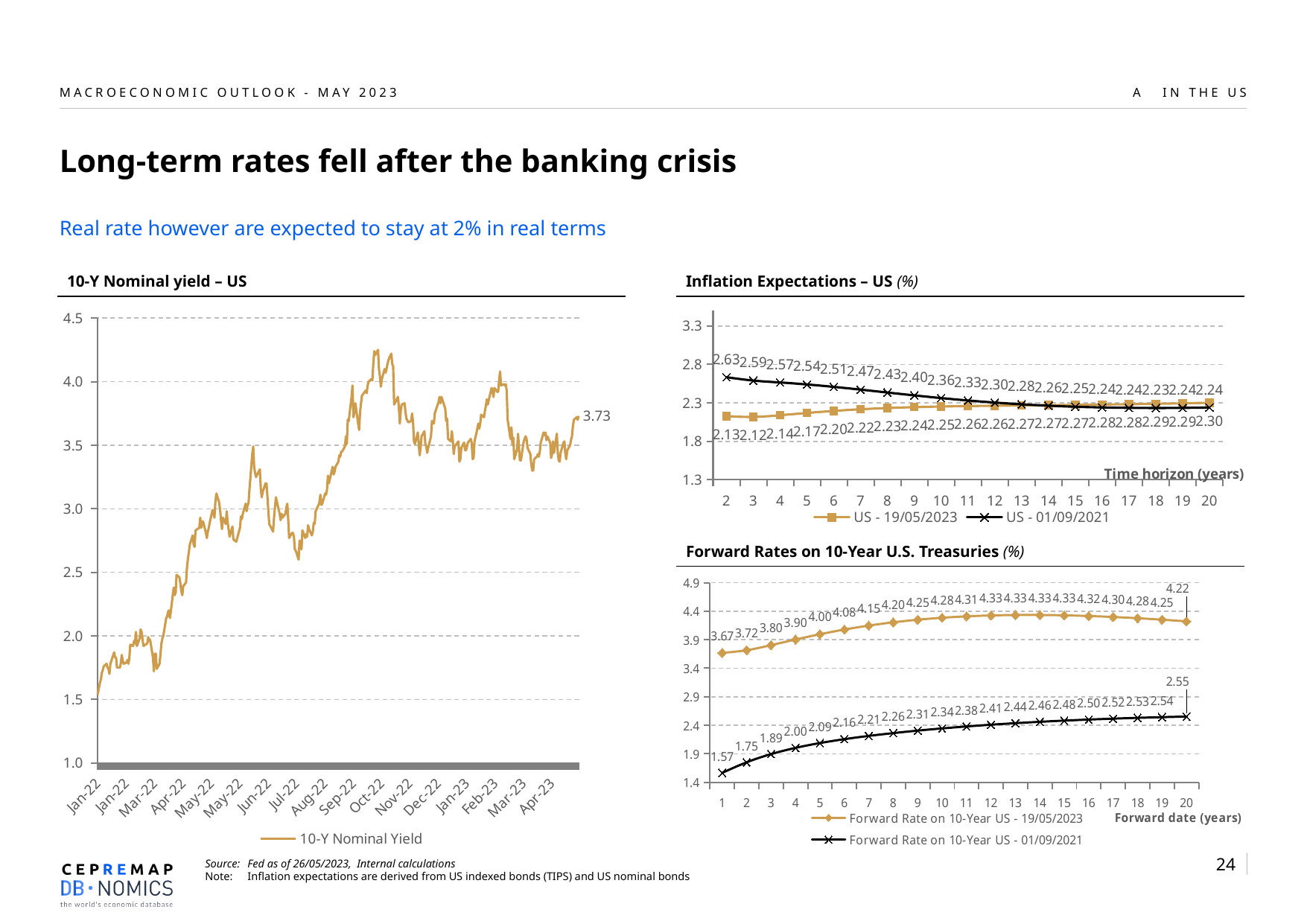
On the 'Inflation Expectations – US (%)' chart, what is the difference between the US - 01/09/2021 and US - 19/05/2023 values at a time horizon of 2 years? 0.50 On the 'Inflation Expectations – US (%)' chart, what is the value for US - 19/05/2023 at a time horizon of 20 years? 2.30 On the 'Forward Rates on 10-Year U.S. Treasuries (%)' chart, what is the value for the 01/09/2021 series at a forward date of 20 years? 2.55 How many series does the legend of the 'Inflation Expectations – US (%)' chart list? 2 On the '10-Y Nominal yield – US' chart, is the value in Jan-22 greater or less than 2.0? less On the 'Inflation Expectations – US (%)' chart, what is the value for US - 01/09/2021 at a time horizon of 2 years? 2.63 On the '10-Y Nominal yield – US' chart, what is the value printed at the end of the line? 3.73 On the 'Forward Rates on 10-Year U.S. Treasuries (%)' chart, what is the value for the 19/05/2023 series at a forward date of 1 year? 3.67 On the 'Forward Rates on 10-Year U.S. Treasuries (%)' chart, how many forward dates are plotted on the x axis? 20 On the 'Inflation Expectations – US (%)' chart, does the US - 01/09/2021 series rise or fall as the time horizon increases? fall On the 'Forward Rates on 10-Year U.S. Treasuries (%)' chart, which forward date has the lowest value for the 01/09/2021 series? 1 What kind of chart is the '10-Y Nominal yield – US' chart? line chart